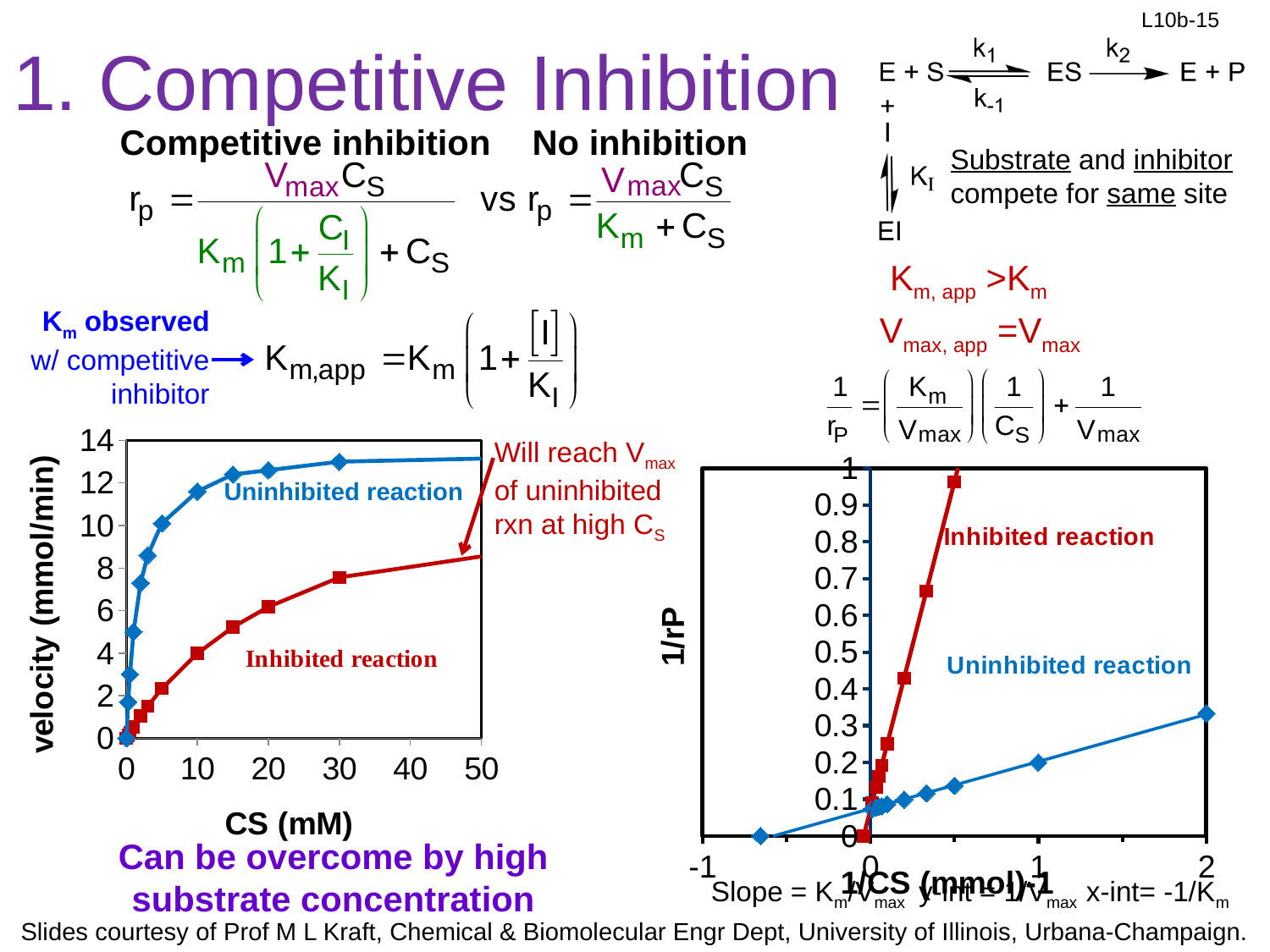
What is the y-axis title of the left chart? velocity (mmol/min) On the left chart (velocity vs CS), does the velocity of the inhibited reaction rise or fall as CS increases? rise On the left chart (velocity vs CS), is the velocity of the uninhibited reaction at CS = 30 mM greater or less than 12? greater What kind of chart is the left chart (velocity vs CS)? line chart On the left chart (velocity vs CS), how many data series are plotted? 2 On the right chart (1/rP vs 1/CS), is the value of 1/rP for the uninhibited reaction at 1/CS = 1 greater or less than 0.3? less What is the y-axis title of the right chart? 1/rP On the right chart (1/rP vs 1/CS), how many data series are plotted? 2 On the right chart (1/rP vs 1/CS), which series has the steeper line, the inhibited reaction or the uninhibited reaction? Inhibited reaction On the left chart (velocity vs CS), which series has the higher velocity at CS = 20 mM, the uninhibited reaction or the inhibited reaction? Uninhibited reaction What kind of chart is the right chart (1/rP vs 1/CS)? line chart On the left chart (velocity vs CS), is the velocity of the inhibited reaction at CS = 10 mM greater or less than 6? less